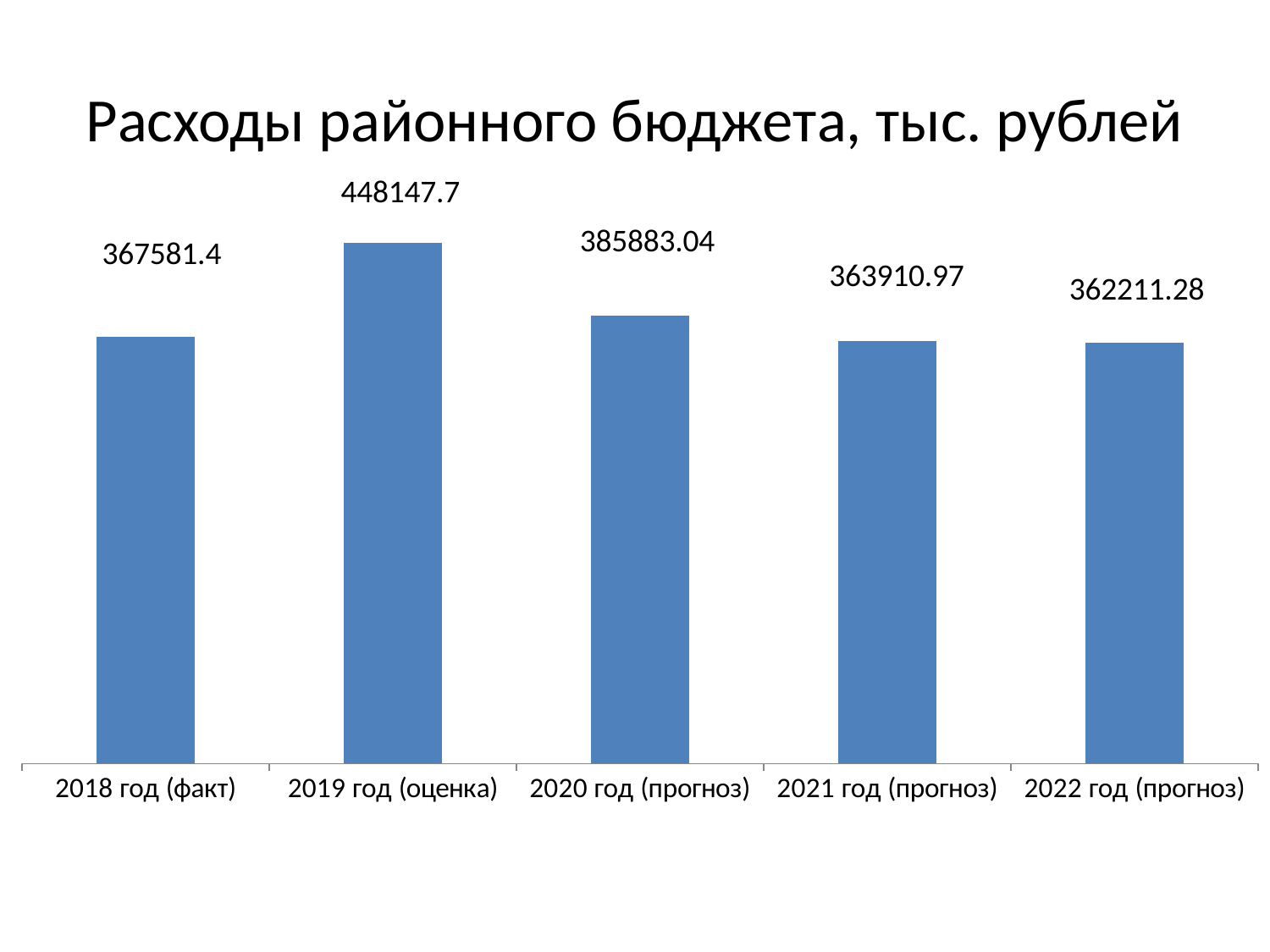
From 2019 год (оценка) to 2022 год (прогноз), do the values rise or fall? fall How many categories are shown on the chart? 5 What kind of chart is this? bar chart What is the value for 2019 год (оценка)? 448147.7 What is the difference between the values for 2020 год (прогноз) and 2021 год (прогноз)? 21972.07 Which is larger, the value for 2021 год (прогноз) or 2022 год (прогноз)? 2021 год (прогноз) What is the difference between the values for 2019 год (оценка) and 2018 год (факт)? 80566.3 What is the value for 2020 год (прогноз)? 385883.04 What is the value for 2022 год (прогноз)? 362211.28 What is the value for 2018 год (факт)? 367581.4 Which category has the highest value? 2019 год (оценка) Which category has the lowest value? 2022 год (прогноз)